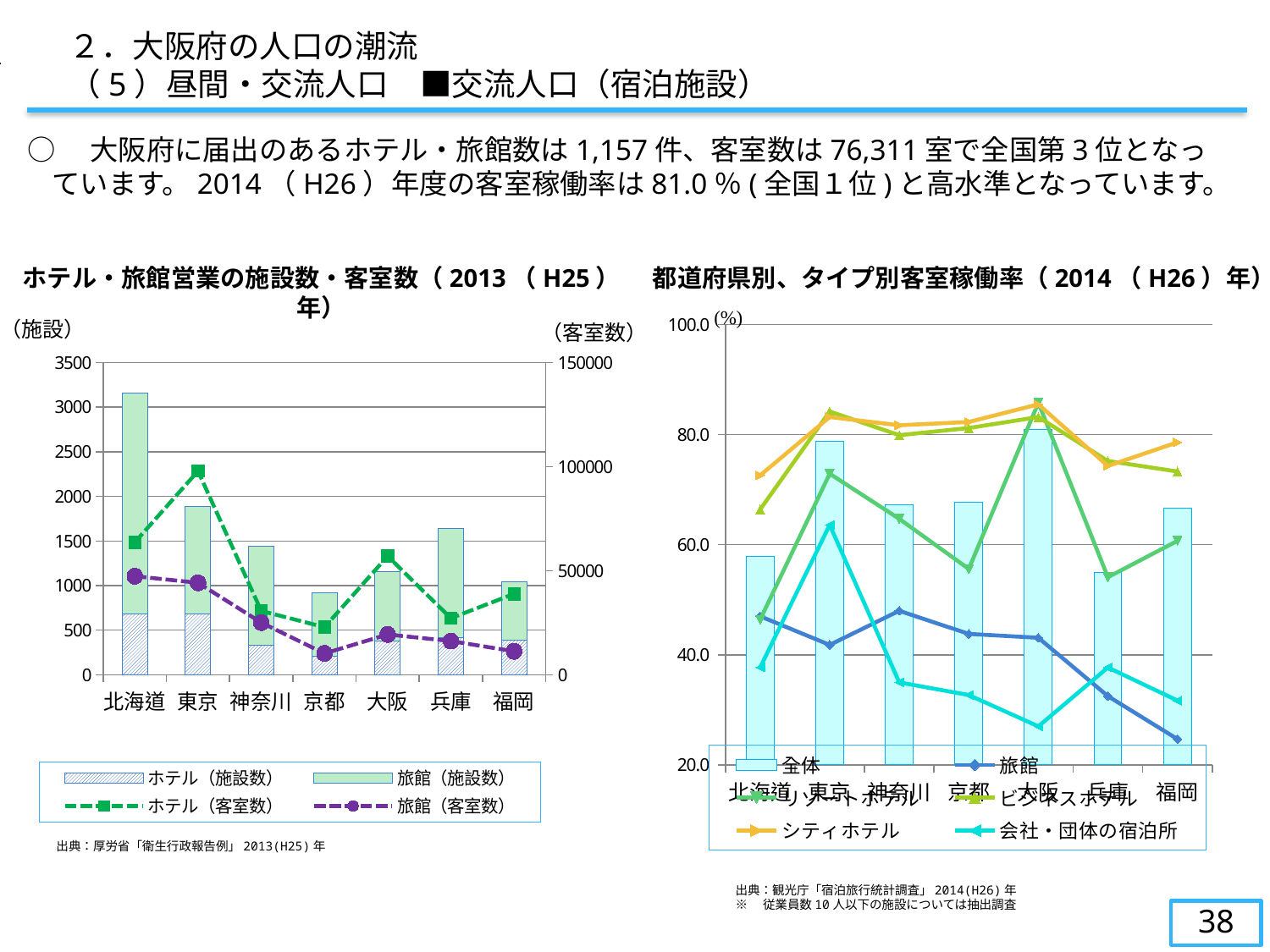
In the right chart (都道府県別、タイプ別客室稼働率), is the 旅館 value for 北海道 greater or less than 40.0? greater In the left chart (ホテル・旅館営業の施設数・客室数), how many series does the legend list? 4 What kind of chart is the right chart (都道府県別、タイプ別客室稼働率)? Combined bar and line chart In the left chart (ホテル・旅館営業の施設数・客室数), is the total facility count for 北海道 greater or less than 3000? greater In the left chart (ホテル・旅館営業の施設数・客室数), which prefecture has the shortest stacked bar for number of facilities? 京都 In the left chart (ホテル・旅館営業の施設数・客室数), which prefecture has the tallest stacked bar for number of facilities? 北海道 In the right chart (都道府県別、タイプ別客室稼働率), is the 会社・団体の宿泊所 value for 大阪 greater or less than 40.0? less In the left chart (ホテル・旅館営業の施設数・客室数), which prefecture has the highest value for ホテル（客室数）? 東京 In the left chart (ホテル・旅館営業の施設数・客室数), how many prefectures are shown on the x axis? 7 In the right chart (都道府県別、タイプ別客室稼働率), how many series does the legend list? 6 In the left chart (ホテル・旅館営業の施設数・客室数), which is larger for 大阪: ホテル（客室数） or 旅館（客室数）? ホテル（客室数） In the right chart (都道府県別、タイプ別客室稼働率), which prefecture has the highest 全体 occupancy rate? 大阪